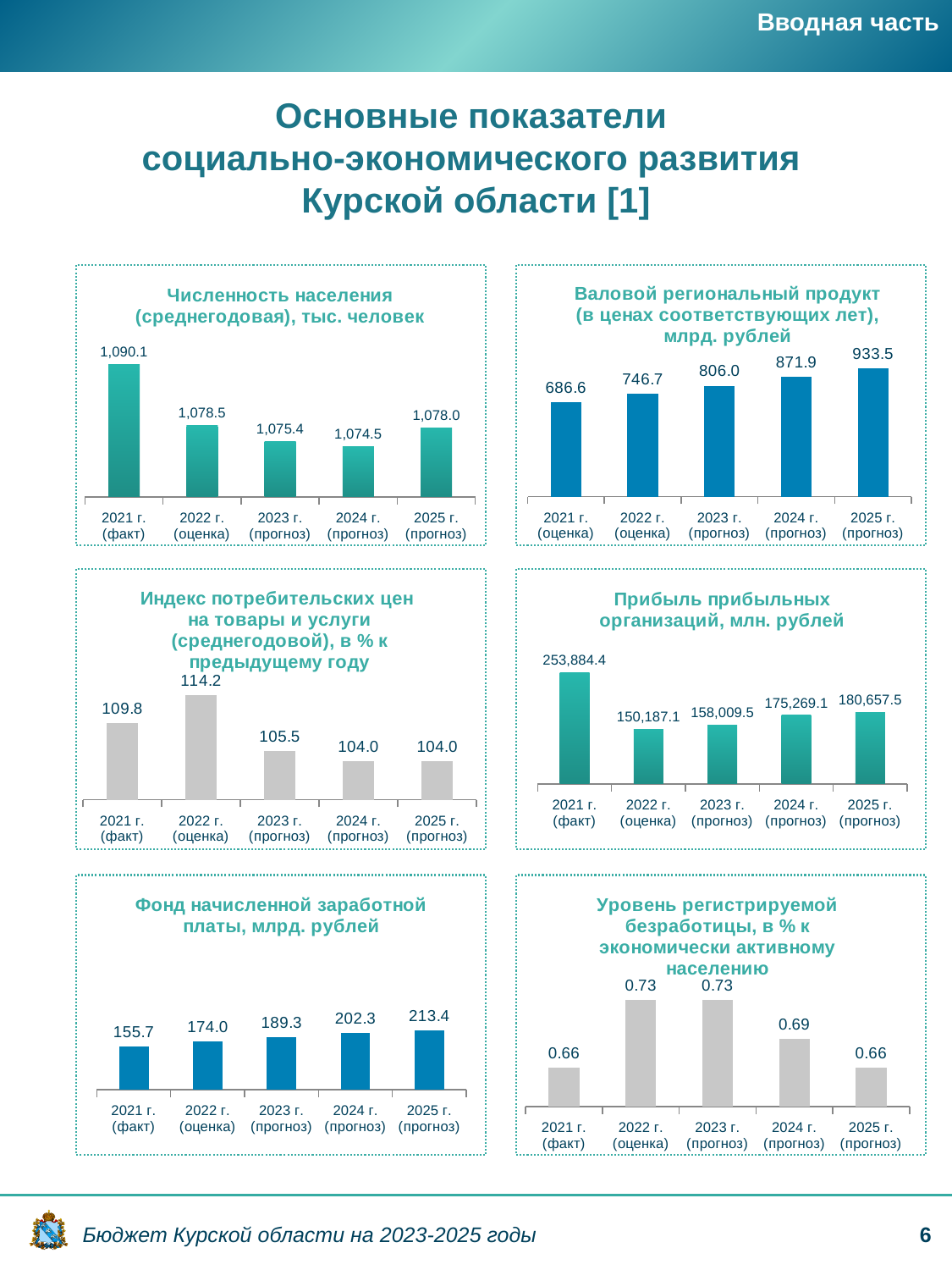
In the chart "Фонд начисленной заработной платы, млрд. рублей", how many bars are plotted? 5 In the chart "Валовой региональный продукт (в ценах соответствующих лет), млрд. рублей", do the values rise or fall from 2021 to 2025? rise In the chart "Прибыль прибыльных организаций, млн. рублей", what is the value for 2022 г. (оценка)? 150,187.1 In the chart "Прибыль прибыльных организаций, млн. рублей", which is larger: the value for 2021 г. (факт) or 2025 г. (прогноз)? 2021 г. (факт) What type of chart is "Уровень регистрируемой безработицы, в % к экономически активному населению"? bar chart In the chart "Уровень регистрируемой безработицы, в % к экономически активному населению", what is the value for 2024 г. (прогноз)? 0.69 In the chart "Валовой региональный продукт (в ценах соответствующих лет), млрд. рублей", what is the value for 2025 г. (прогноз)? 933.5 In the chart "Индекс потребительских цен на товары и услуги (среднегодовой), в % к предыдущему году", what is the difference between the 2022 г. (оценка) and 2023 г. (прогноз) values? 8.7 In the chart "Фонд начисленной заработной платы, млрд. рублей", what is the difference between the 2025 г. (прогноз) and 2021 г. (факт) values? 57.7 In the chart "Индекс потребительских цен на товары и услуги (среднегодовой), в % к предыдущему году", which year has the highest value? 2022 г. (оценка) In the chart "Численность населения (среднегодовая), тыс. человек", which year has the lowest value? 2024 г. (прогноз) In the chart "Численность населения (среднегодовая), тыс. человек", what is the value for 2021 г. (факт)? 1,090.1